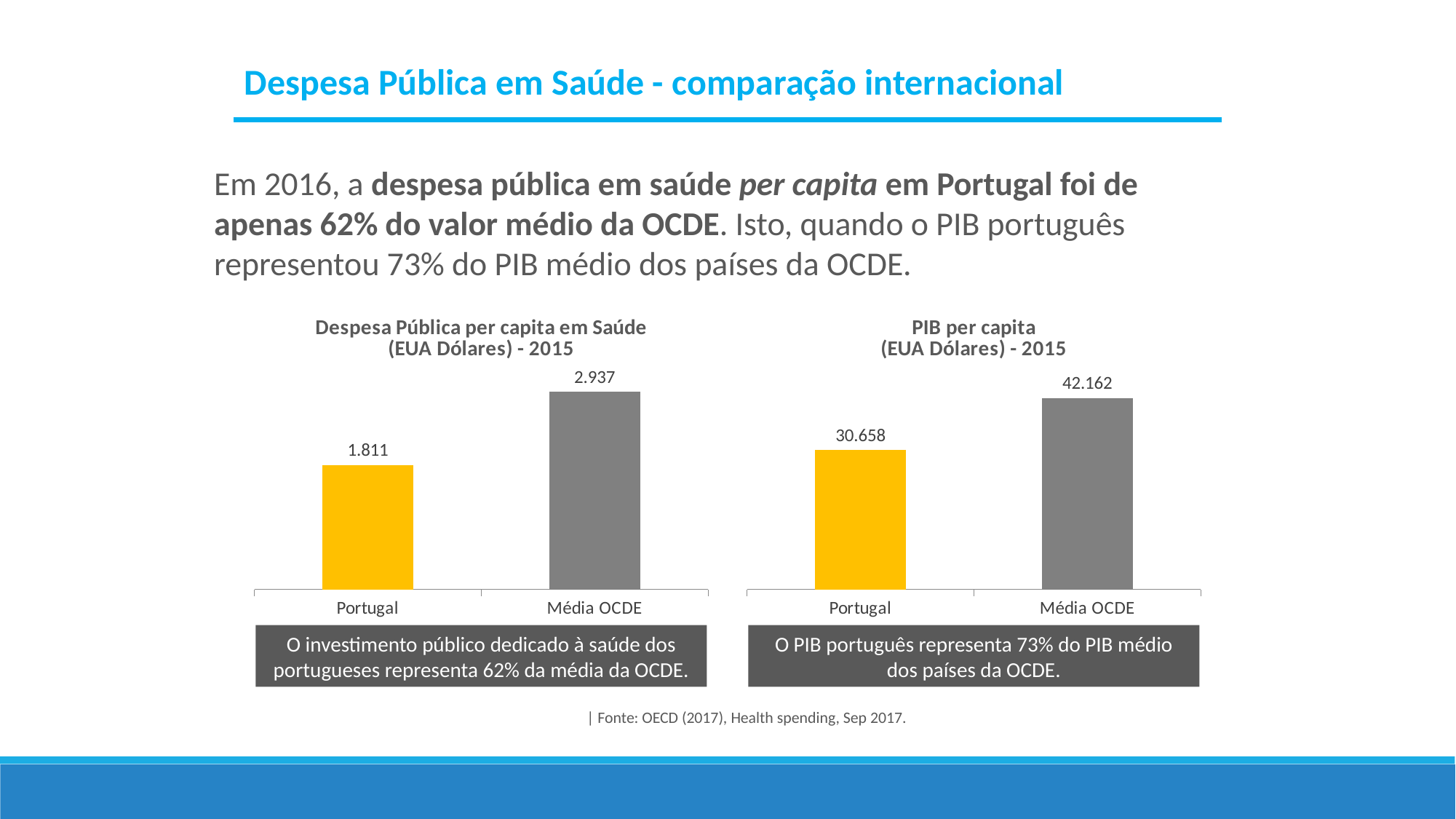
In the chart 'PIB per capita (EUA Dólares) - 2015', what is the value for Portugal? 30.658 In the chart 'Despesa Pública per capita em Saúde (EUA Dólares) - 2015', which category has the highest value? Média OCDE In the chart 'Despesa Pública per capita em Saúde (EUA Dólares) - 2015', what is the value for Média OCDE? 2.937 In the chart 'PIB per capita (EUA Dólares) - 2015', what is the value for Média OCDE? 42.162 In the chart 'PIB per capita (EUA Dólares) - 2015', which is larger: the value for Portugal or the value for Média OCDE? Média OCDE In the chart 'Despesa Pública per capita em Saúde (EUA Dólares) - 2015', what is the difference between the Média OCDE value and the Portugal value? 1.126 In the chart 'PIB per capita (EUA Dólares) - 2015', what is the difference between the Média OCDE value and the Portugal value? 11.504 In the chart 'Despesa Pública per capita em Saúde (EUA Dólares) - 2015', what colour is the bar for Portugal? Yellow In the chart 'PIB per capita (EUA Dólares) - 2015', which category has the lowest value? Portugal How many categories are shown in the chart 'Despesa Pública per capita em Saúde (EUA Dólares) - 2015'? 2 In the chart 'Despesa Pública per capita em Saúde (EUA Dólares) - 2015', what is the value for Portugal? 1.811 What kind of chart is the chart on the right, 'PIB per capita (EUA Dólares) - 2015'? Bar chart